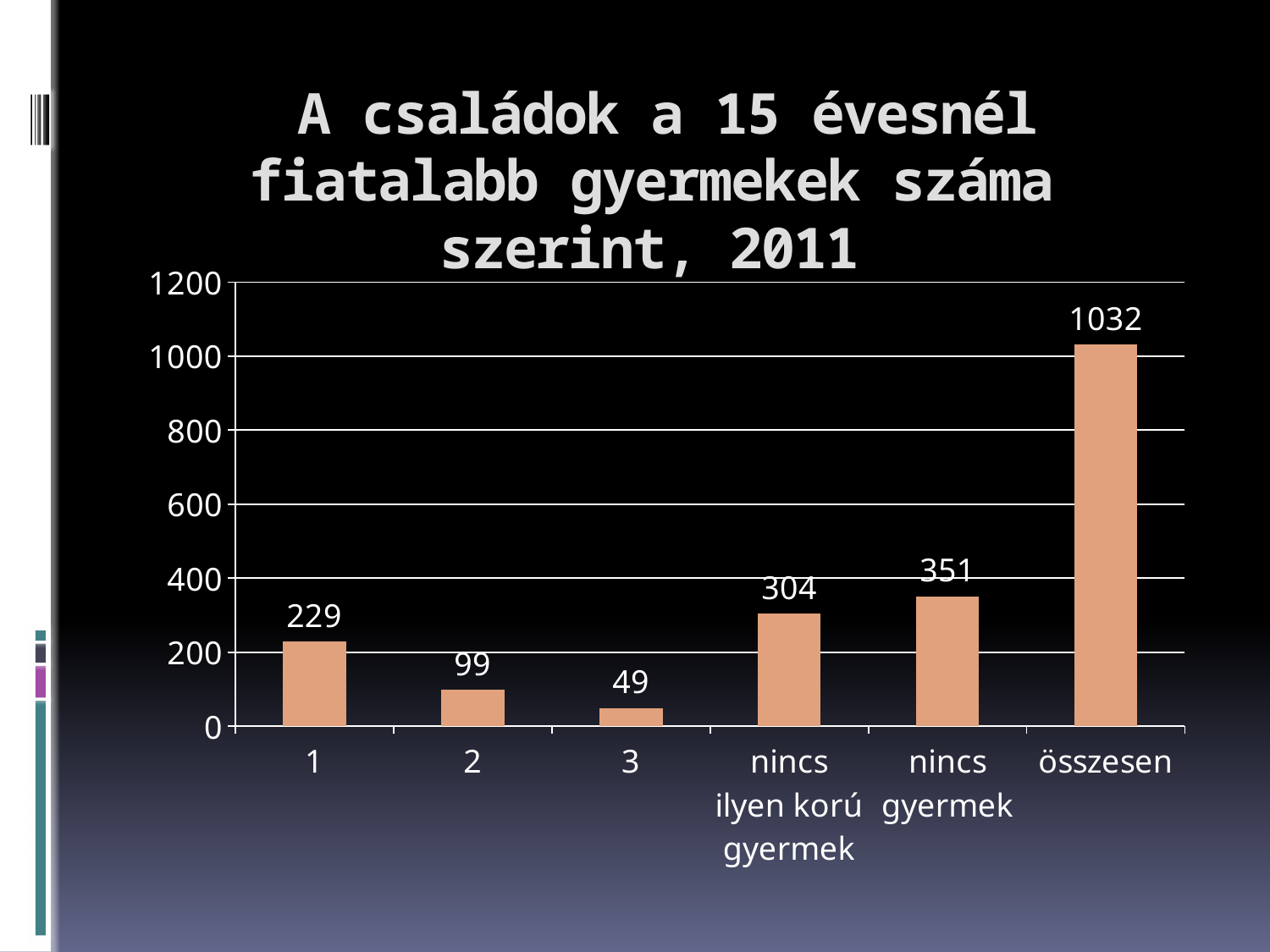
What is the title of the chart? A családok a 15 évesnél fiatalabb gyermekek száma szerint, 2011 What is the value for "nincs gyermek"? 351 How many categories are shown on the x axis? 6 What is the difference between the values for "1" and "2"? 130 What is the value for "nincs ilyen korú gyermek"? 304 Which is larger, the value for "2" or the value for "3"? 2 What kind of chart is shown on the slide? bar chart Which category has the highest value? összesen Which category has the lowest value? 3 Is the value for "összesen" greater or less than 1000? greater What is the difference between "nincs gyermek" and "nincs ilyen korú gyermek"? 47 What is the value for category "1"? 229